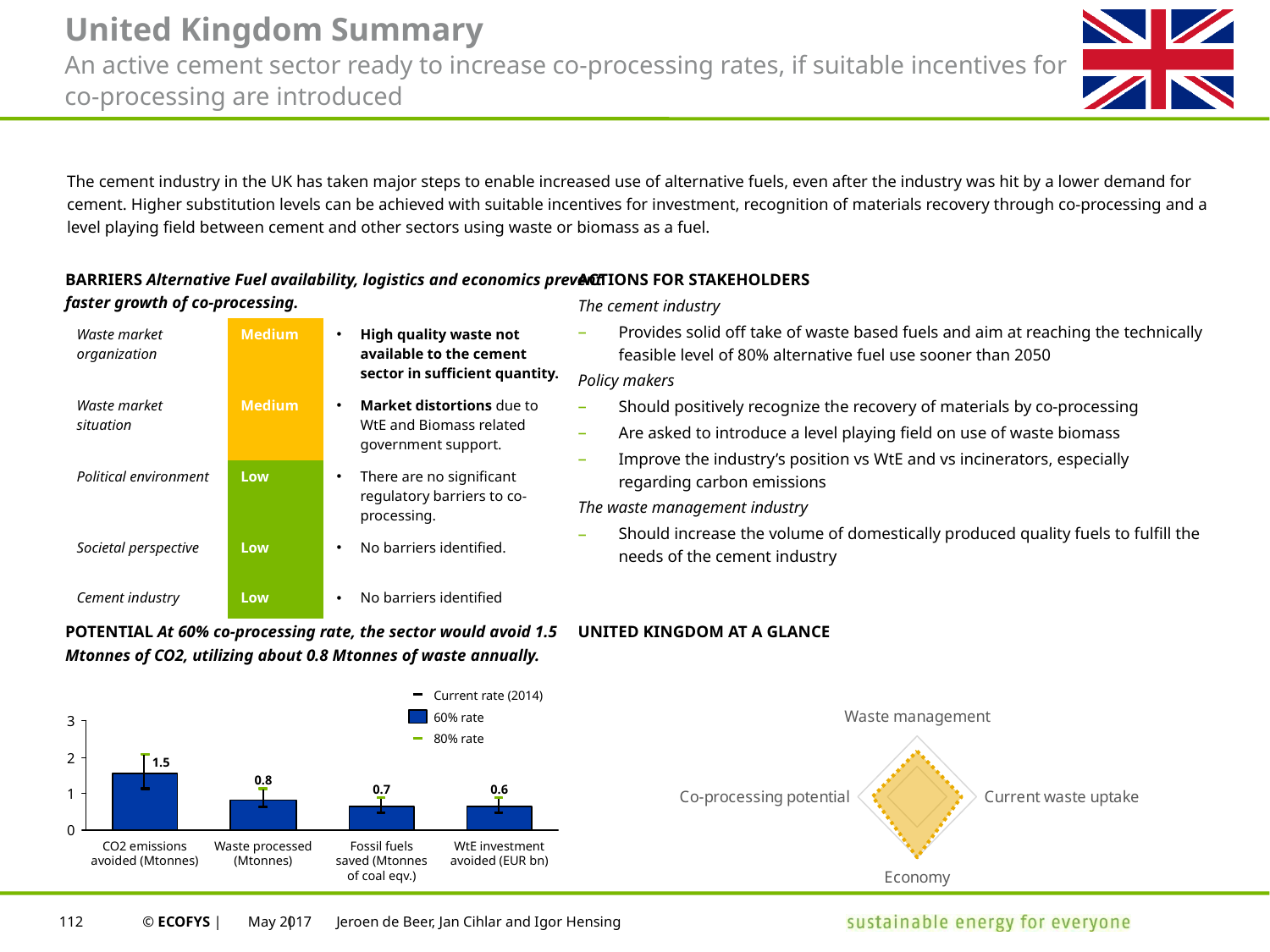
In the bar chart at the bottom left, how many entries does the legend list? 3 In the bar chart at the bottom left, what is the value for Fossil fuels saved (Mtonnes of coal eqv.) at the 60% rate? 0.7 In the bar chart at the bottom left, what is the value for Waste processed (Mtonnes) at the 60% rate? 0.8 In the bar chart at the bottom left, do the 60% rate values rise or fall from left to right along the x axis? Fall In the bar chart at the bottom left, which category has the lowest 60% rate value? WtE investment avoided (EUR bn) In the bar chart at the bottom left, which category has the highest 60% rate value? CO2 emissions avoided (Mtonnes) What kind of chart is shown at the bottom left of the slide? Bar chart In the bar chart at the bottom left, what is the difference between the 60% rate values for CO2 emissions avoided and Waste processed? 0.7 In the bar chart at the bottom left, how many categories are shown on the x axis? 4 In the bar chart at the bottom left, which is larger at the 60% rate: Waste processed or Fossil fuels saved? Waste processed In the bar chart at the bottom left, what is the value for CO2 emissions avoided (Mtonnes) at the 60% rate? 1.5 In the bar chart at the bottom left, what is the value for WtE investment avoided (EUR bn) at the 60% rate? 0.6